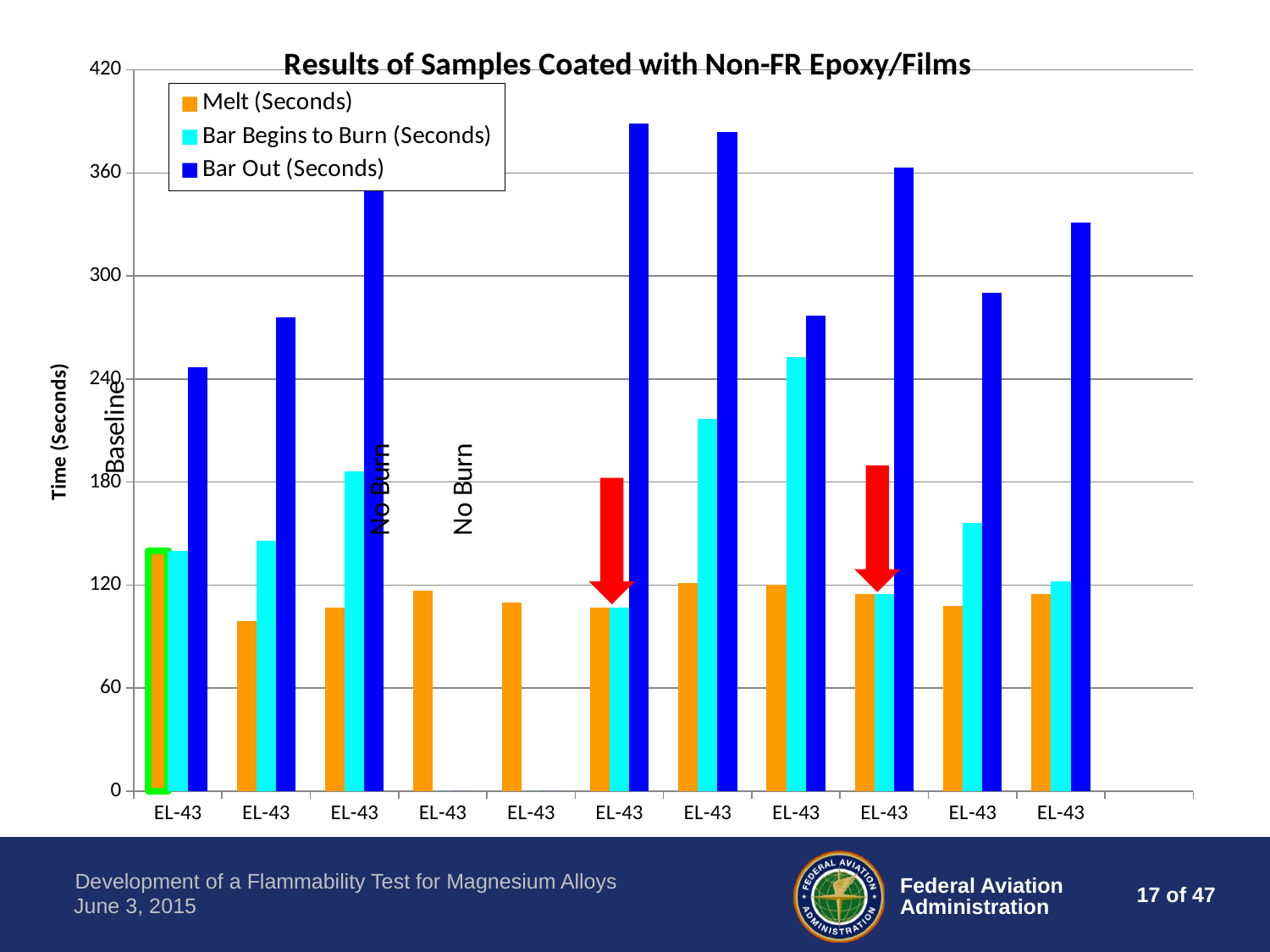
How many category groups are shown along the x axis? 11 Is the Bar Out (Seconds) value for the third EL-43 group greater or less than 300? greater How many category groups are annotated with "No Burn"? 2 Is the Bar Out (Seconds) value for the sixth EL-43 group greater or less than 360? greater How many series does the legend list? 3 Is the Bar Begins to Burn (Seconds) value for the eighth EL-43 group greater or less than 180? greater In the seventh EL-43 group, which is larger: the Bar Out (Seconds) value or the Bar Begins to Burn (Seconds) value? Bar Out (Seconds) What type of chart is shown on the slide? bar chart Which has the larger Bar Out (Seconds) value: the first EL-43 group or the sixth EL-43 group? the sixth EL-43 group What is the title of the chart? Results of Samples Coated with Non-FR Epoxy/Films